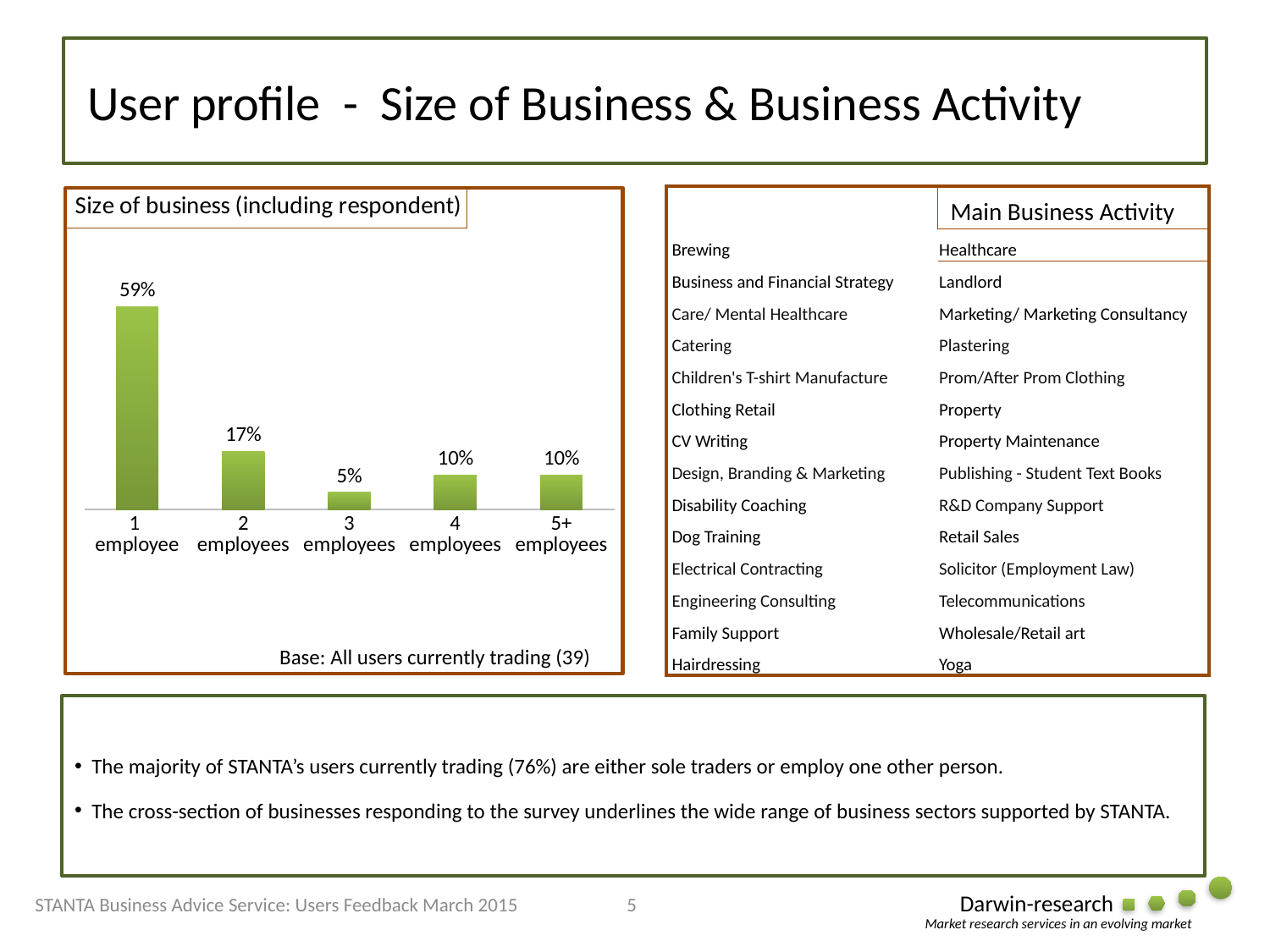
Which is larger, the value for 2 employees or the value for 4 employees? 2 employees What is the title of the chart? Size of business (including respondent) What is the base stated for the chart? All users currently trading (39) What is the difference in percentage points between the 1 employee and 2 employees categories? 42 What percentage of businesses have 5+ employees? 10% What percentage of businesses have 3 employees? 5% Which size of business category has the highest percentage? 1 employee What percentage of businesses have 2 employees? 17% What type of chart is used to show the size of business? Bar chart How many size-of-business categories are shown in the chart? 5 What percentage of businesses have 1 employee? 59% Which size of business category has the lowest percentage? 3 employees